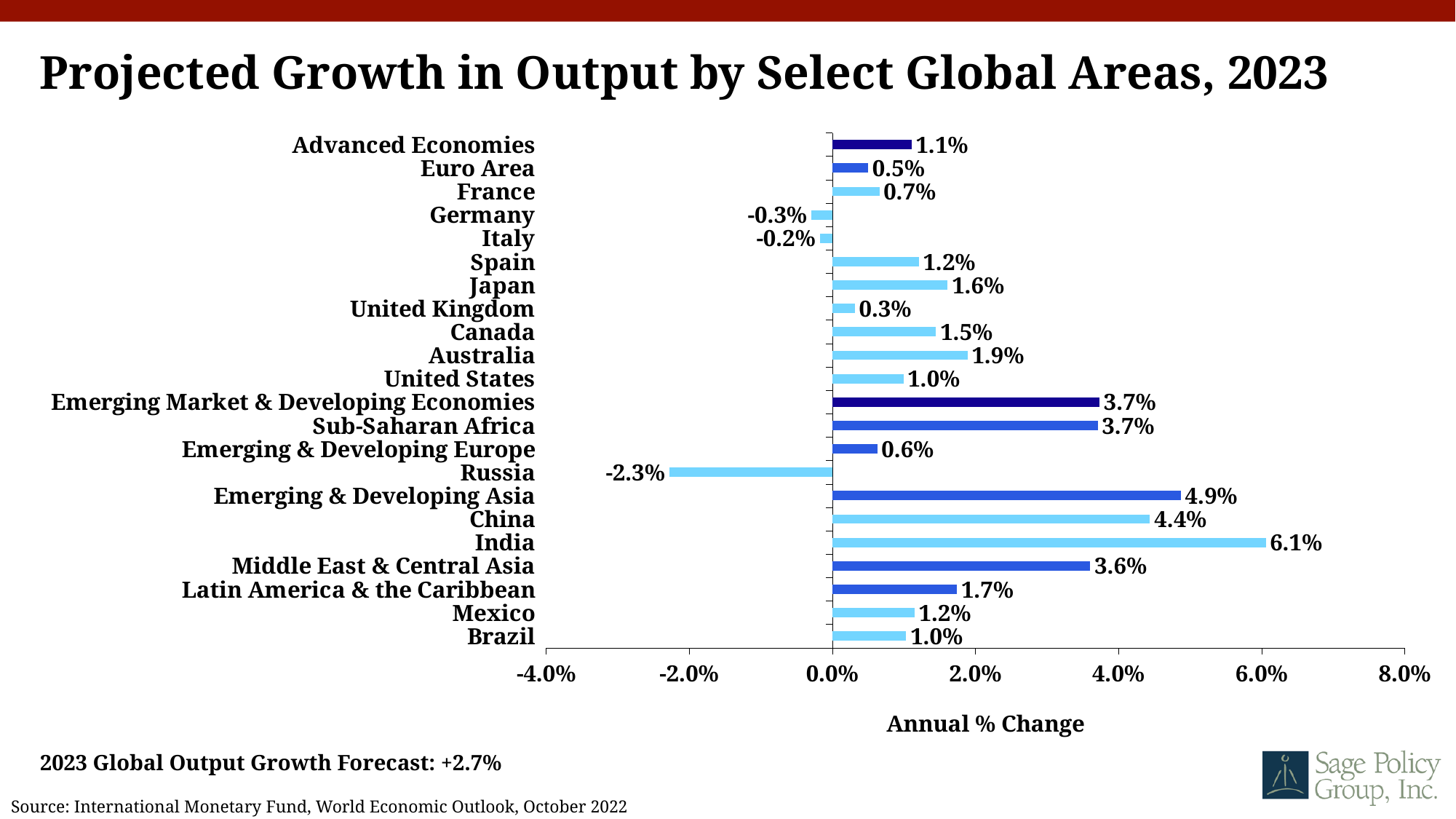
What is the 2023 Global Output Growth Forecast stated on the slide? +2.7% What is the difference between the projected growth for China and the United States? 3.4% What is the projected 2023 output growth for Russia? -2.3% What is the projected 2023 output growth for India? 6.1% Which has the higher projected growth for 2023, Japan or Canada? Japan Which area has the highest projected growth in output for 2023? India What is the label of the horizontal axis? Annual % Change What kind of chart is shown on the slide? Bar chart How many areas are listed on the chart? 22 What is the projected 2023 output growth for Germany? -0.3% Is the projected growth for Emerging & Developing Asia greater or less than 4.0%? greater Which area has the lowest projected growth in output for 2023? Russia